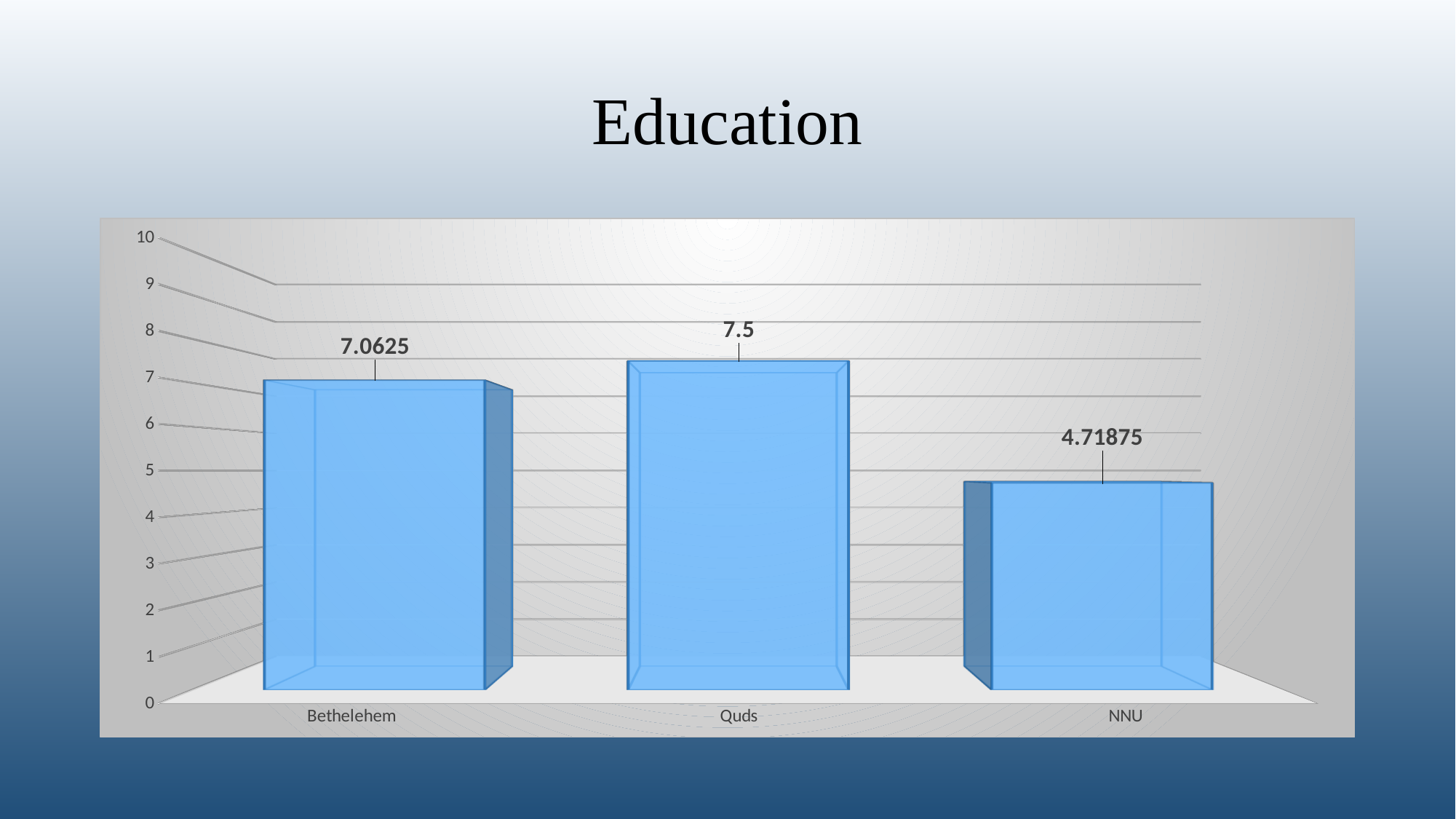
Which category has the lowest value? NNU Which category has the highest value? Quds What is the value for NNU? 4.71875 What is the value for Quds? 7.5 What is the value for Bethelehem? 7.0625 What kind of chart is shown on the slide? bar chart How many categories are shown on the x axis? 3 Is the value for NNU greater or less than 5? less Which is larger, the value for Bethelehem or the value for NNU? Bethelehem What is the difference between the values for Bethelehem and NNU? 2.34375 What is the difference between the values for Quds and Bethelehem? 0.4375 What is the title of the slide? Education